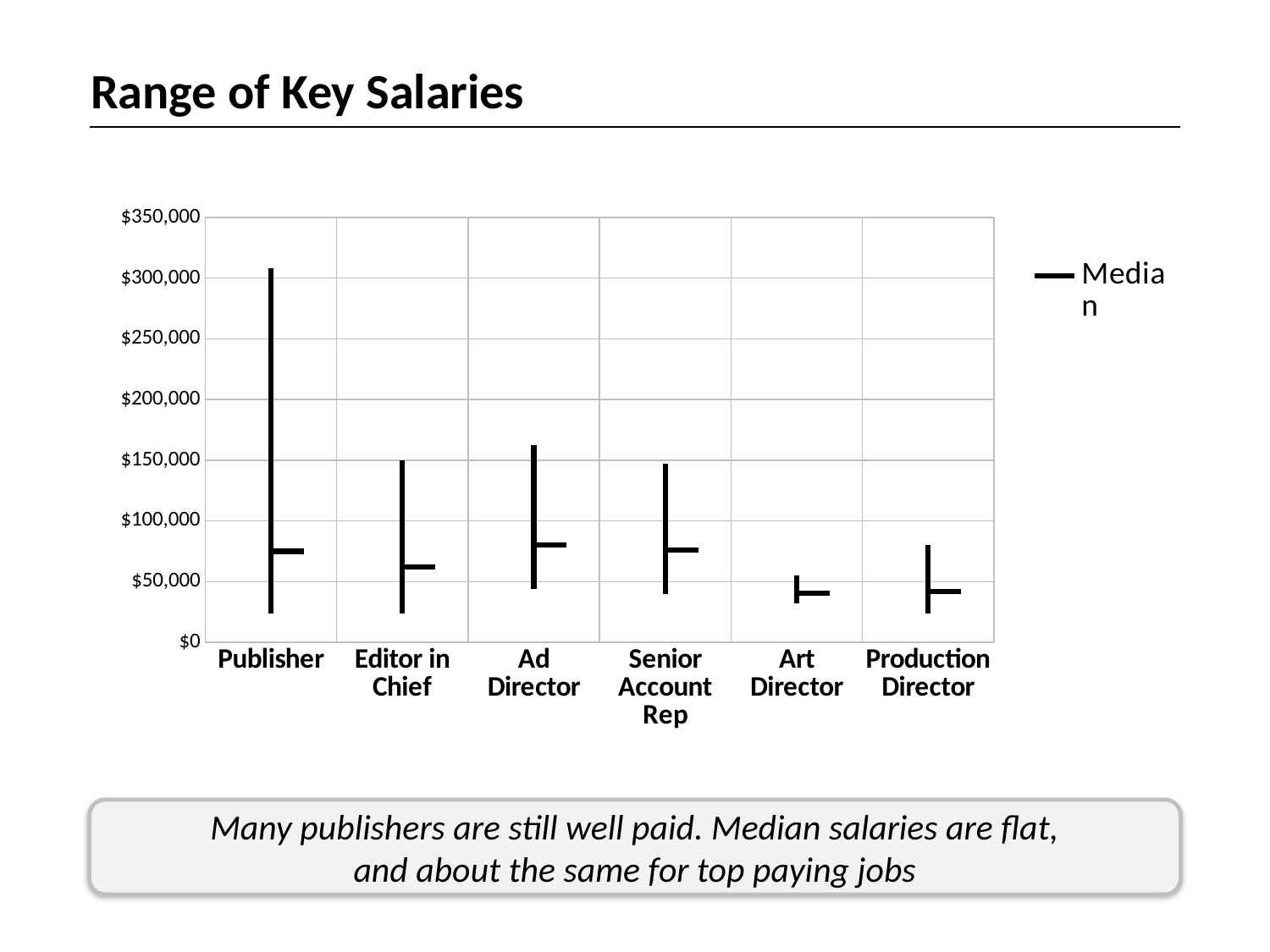
How many job categories are shown on the x axis of the chart? 6 Which has a higher top of salary range, Ad Director or Production Director? Ad Director Is the median salary for Art Director greater or less than $50,000? less What kind of chart is shown on the slide? high-low line chart Which job category has the highest top of its salary range? Publisher How many series does the chart legend list? 1 Is the top of the salary range for Publisher greater or less than $250,000? greater Is the top of the salary range for Ad Director greater or less than $150,000? greater What is the highest value shown on the y axis of the chart? $350,000 Which job category has the lowest top of its salary range? Art Director What is the name of the series listed in the chart legend? Median